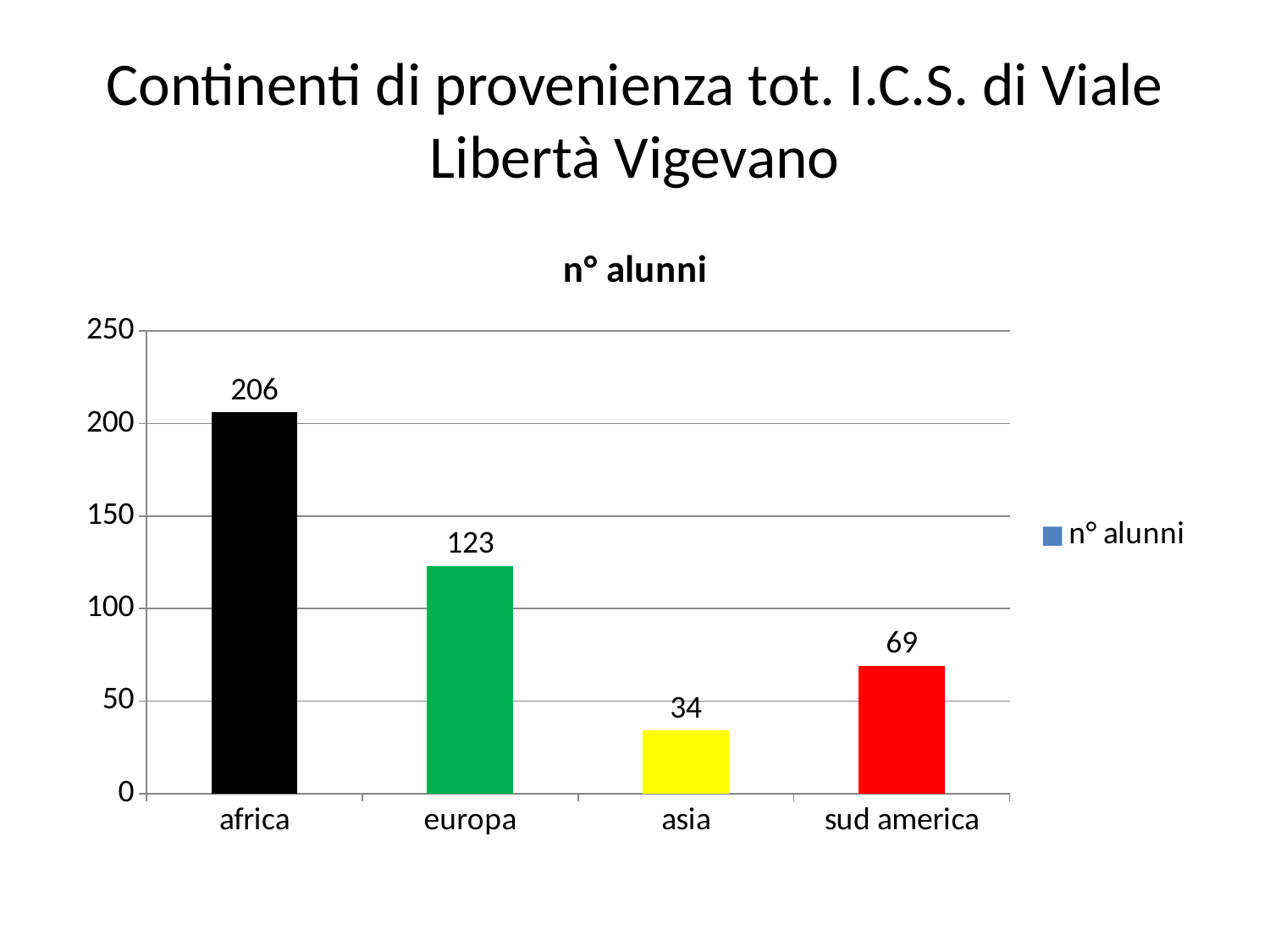
How many categories are shown on the x axis? 4 What is the difference between the values for africa and europa? 83 What is the title of the chart? n° alunni Which is larger, the value for sud america or the value for asia? sud america What is the value for africa? 206 Which category has the lowest value? asia What is the value for asia? 34 Which category has the highest value? africa What kind of chart is shown on the slide? bar chart What is the value for europa? 123 Is the value for europa greater or less than 100? greater What is the value for sud america? 69